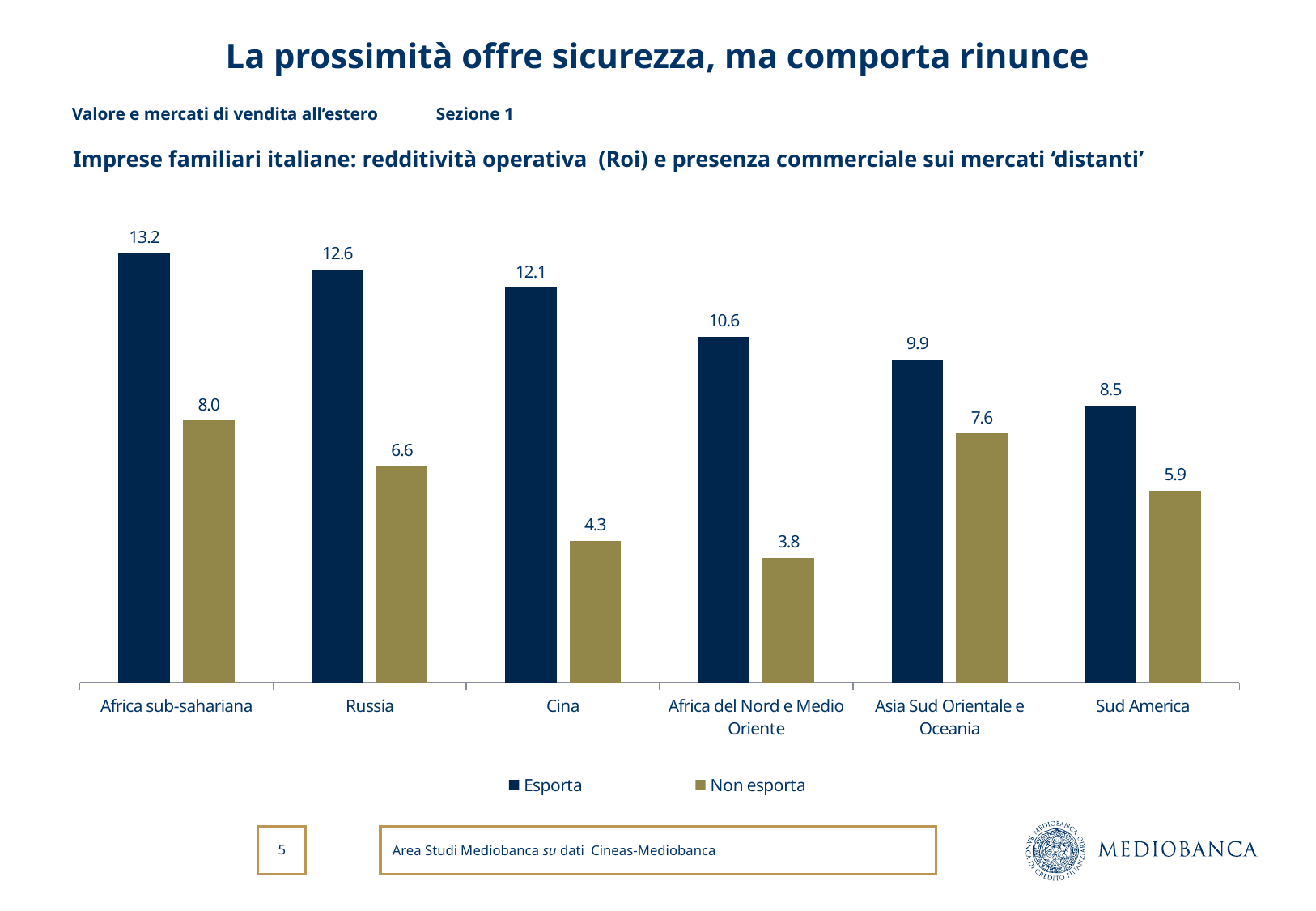
Which category has the lowest Non esporta value? Africa del Nord e Medio Oriente How many series does the legend list? 2 How many categories are shown on the x axis? 6 Which is larger: the Non esporta value for Asia Sud Orientale e Oceania or the Non esporta value for Africa sub-sahariana? Africa sub-sahariana Which category has the highest Esporta value? Africa sub-sahariana What are the two series listed in the legend? Esporta and Non esporta Do the Esporta values rise or fall from Africa sub-sahariana to Sud America? Fall What is the difference between the Esporta and Non esporta values for Russia? 6.0 What is the Non esporta value for Africa del Nord e Medio Oriente? 3.8 What kind of chart is shown on the slide? Bar chart What is the Esporta value for Cina? 12.1 What is the Non esporta value for Sud America? 5.9